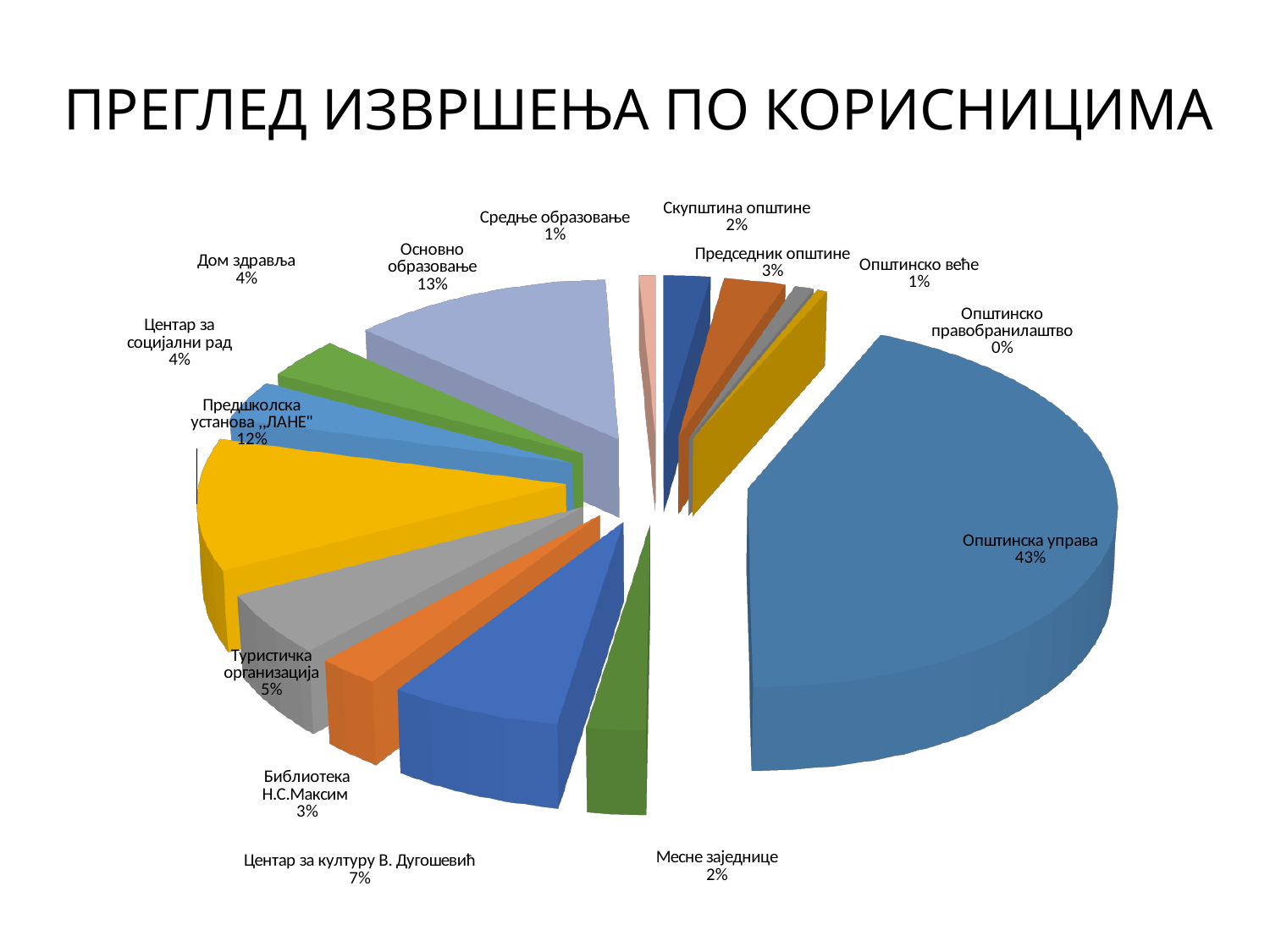
What is the difference between the shares of Општинска управа and Основно образовање? 30% What is the value shown for Основно образовање? 13% What is the value shown for Предшколска установа „ЛАНЕ"? 12% What is the title of the chart on the slide? ПРЕГЛЕД ИЗВРШЕЊА ПО КОРИСНИЦИМА What share of the pie does Општинска управа have? 43% Which category has the smallest share of the pie? Општинско правобранилаштво Which is larger, the share for Туристичка организација or the share for Библиотека Н.С.Максим? Туристичка организација Which category has the largest share of the pie? Општинска управа What kind of chart is shown on the slide? Pie chart What is the value shown for Председник општине? 3% How many categories are shown in the pie chart? 14 What is the value shown for Центар за културу В. Дугошевић? 7%